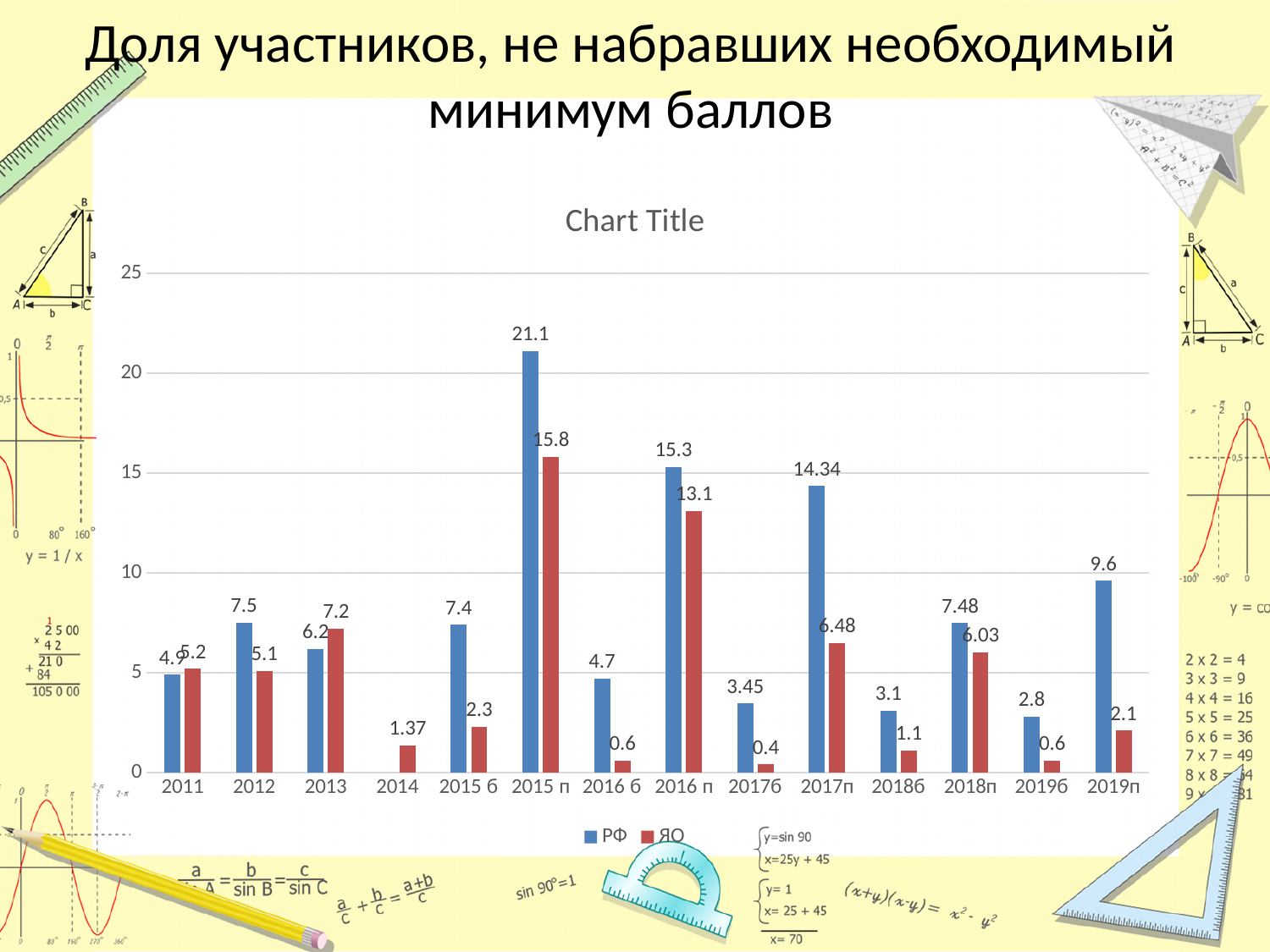
Which is larger in 2013, the РФ value or the ЯО value? ЯО What is the value for РФ in 2015 п? 21.1 What type of chart is shown on the slide? bar chart Which category has the lowest value for ЯО? 2017б What is the difference between the РФ and ЯО values in 2016 п? 2.2 How many categories are shown on the x axis? 14 How many series does the legend list? 2 What is the value for ЯО in 2014? 1.37 Is the value for РФ in 2017п greater or less than 10? greater What is the value for ЯО in 2017п? 6.48 What colour are the bars for the ЯО series? red Which category has the highest value for РФ? 2015 п